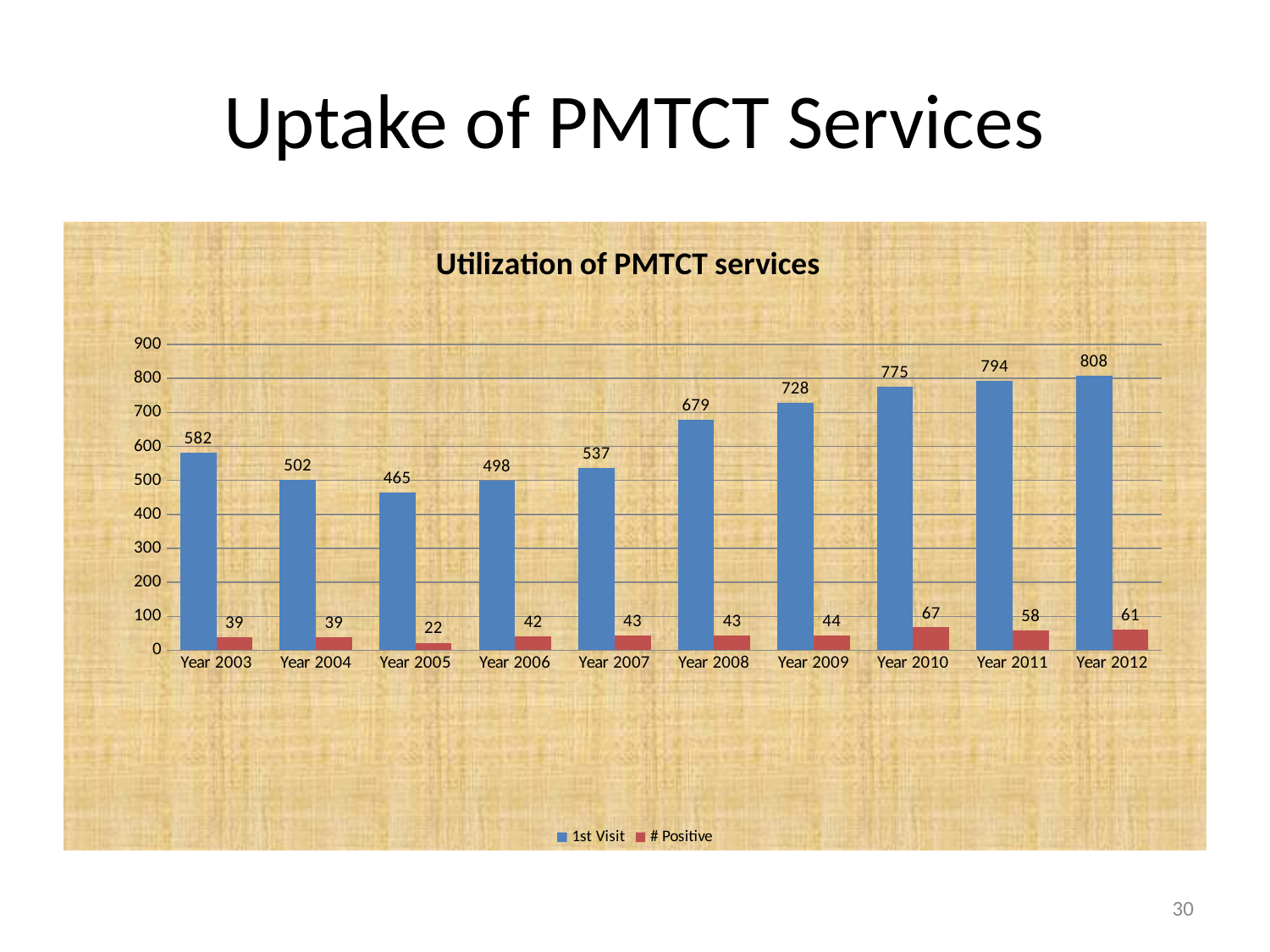
What is the title of the chart? Utilization of PMTCT services How many series does the legend list? 2 What is the 1st Visit value for Year 2008? 679 What is the # Positive value for Year 2010? 67 Which year has the highest 1st Visit value? Year 2012 Do the 1st Visit values rise or fall from Year 2005 to Year 2012? rise What kind of chart is shown? bar chart What is the difference between the 1st Visit values for Year 2012 and Year 2003? 226 Is the 1st Visit value for Year 2009 greater or less than 700? greater Which year has the lowest # Positive value? Year 2005 How many years are shown on the x axis? 10 Which is larger, the # Positive value for Year 2011 or for Year 2012? Year 2012